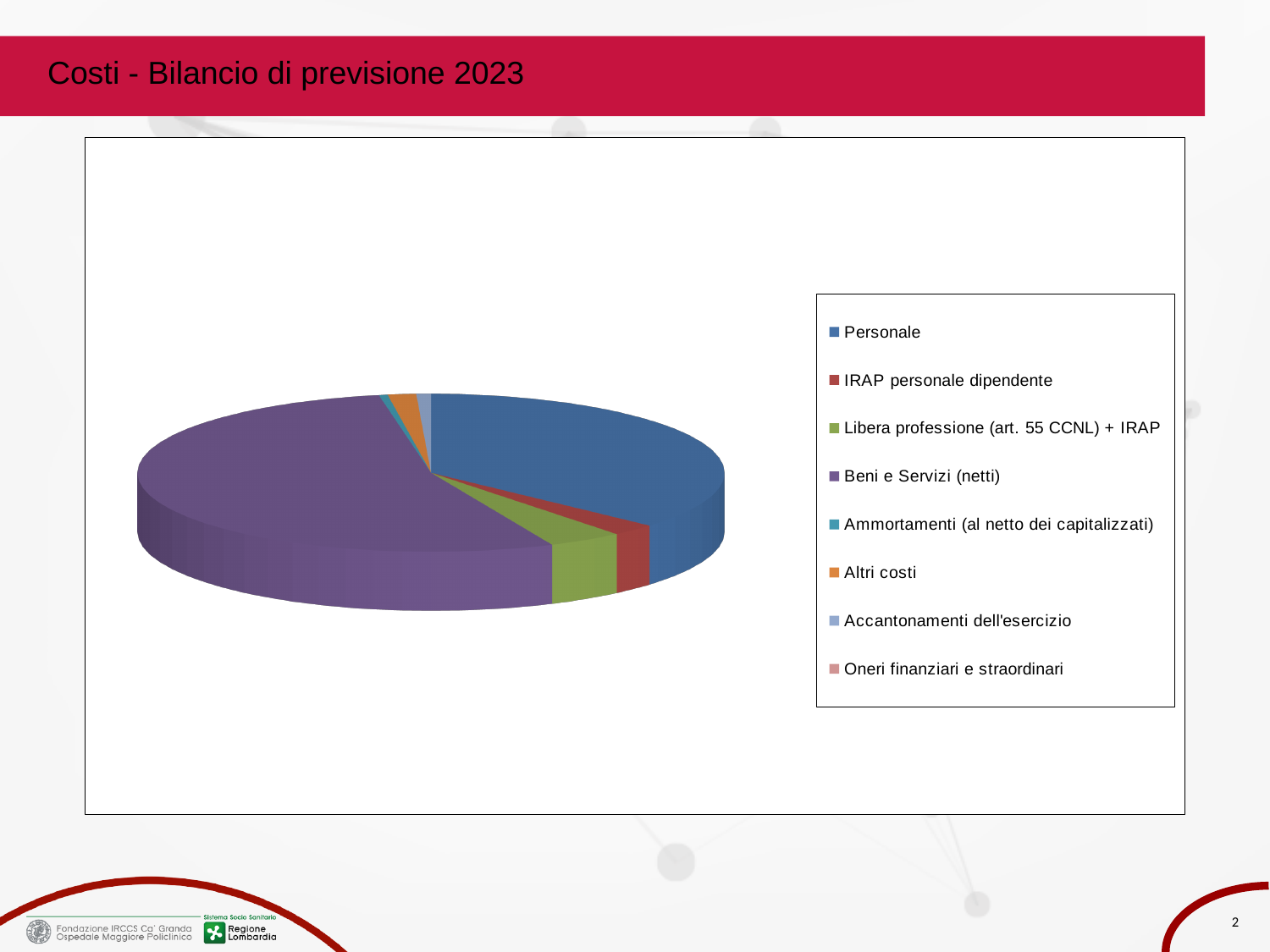
Which is larger in the pie chart: the slice for Beni e Servizi (netti) or the slice for Libera professione (art. 55 CCNL) + IRAP? Beni e Servizi (netti) How many categories does the legend of the pie chart list? 8 What is the title of the slide containing the pie chart? Costi - Bilancio di previsione 2023 Which category has the largest slice of the pie chart? Beni e Servizi (netti) Which category is listed first in the legend of the pie chart? Personale Which is larger in the pie chart: the slice for Beni e Servizi (netti) or the slice for Personale? Beni e Servizi (netti) Which is larger in the pie chart: the slice for Personale or the slice for IRAP personale dipendente? Personale What kind of chart is shown on the slide? pie chart